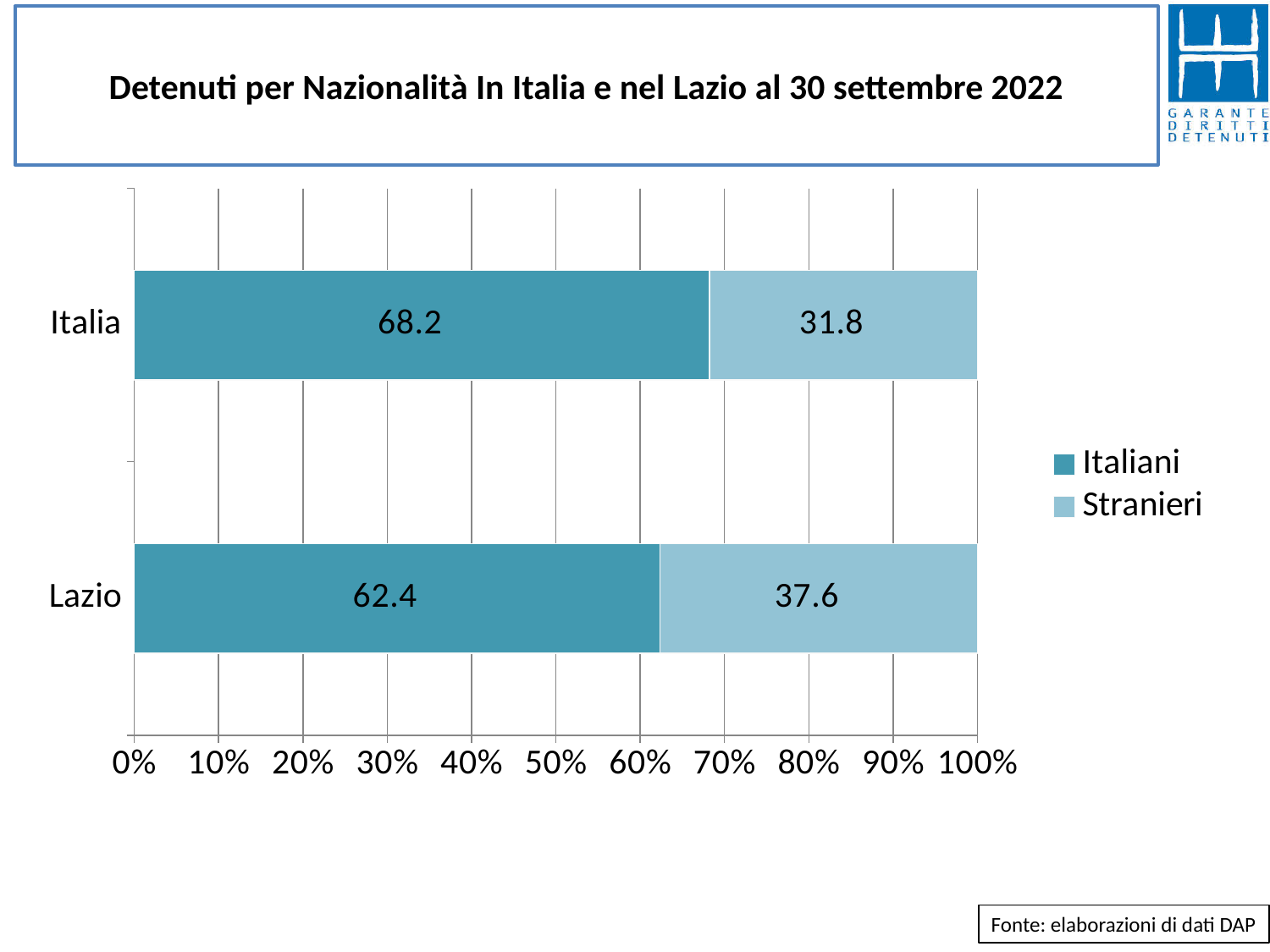
Which category has the higher Stranieri value, Italia or Lazio? Lazio What is the difference between the Stranieri values for Lazio and Italia? 5.8 How many series does the legend list? 2 What is the value for Stranieri in Italia? 31.8 What is the title of the slide? Detenuti per Nazionalità In Italia e nel Lazio al 30 settembre 2022 How many categories are shown on the chart? 2 What is the difference between the Italiani values for Italia and Lazio? 5.8 What is the value for Italiani in Italia? 68.2 What is the value for Stranieri in Lazio? 37.6 What kind of chart is shown on the slide? Stacked bar chart What is the value for Italiani in Lazio? 62.4 Which category has the higher Italiani value, Italia or Lazio? Italia